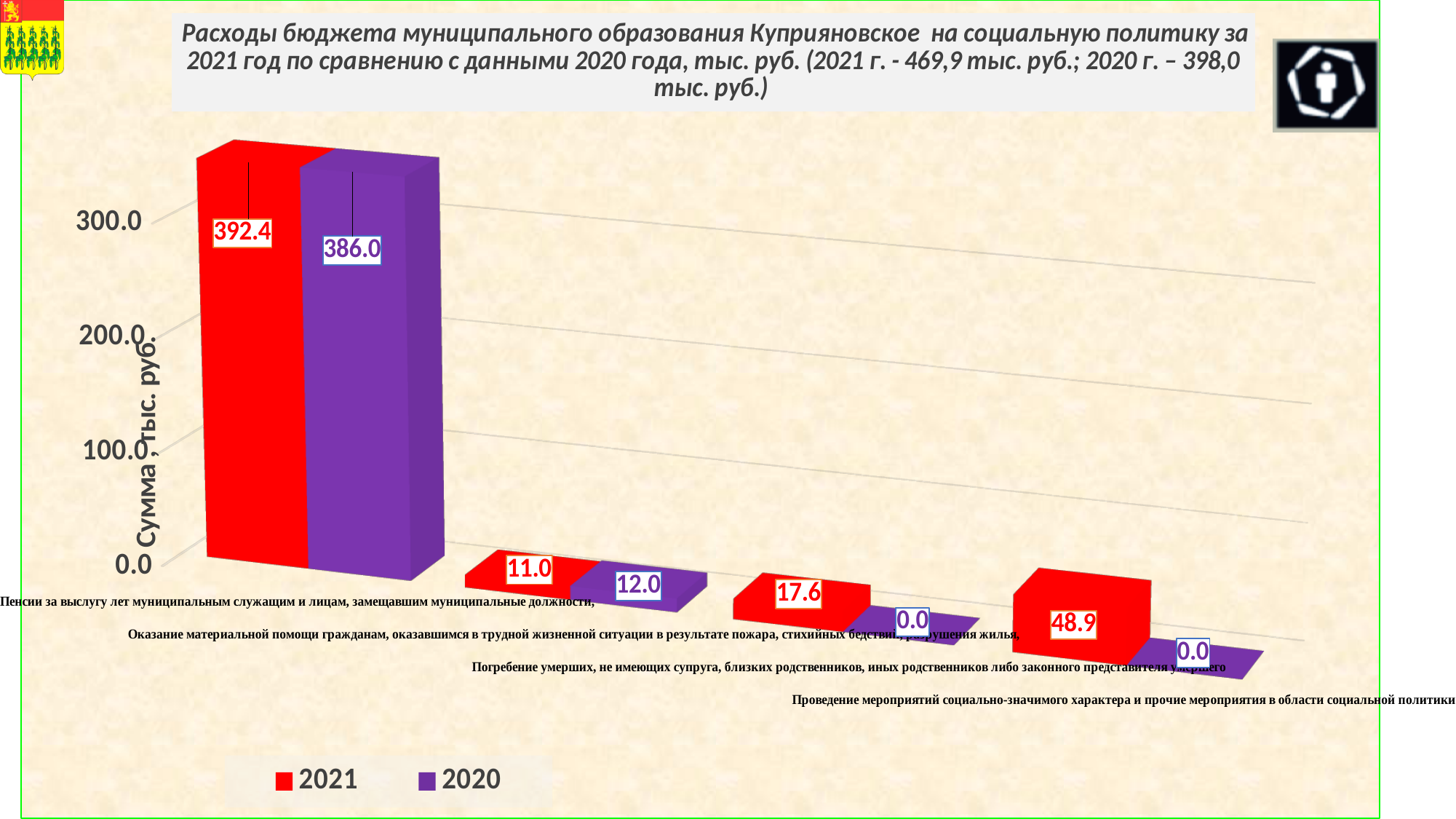
What kind of chart is shown on the slide? Bar chart Which category has the highest 2021 value? Пенсии за выслугу лет муниципальным служащим и лицам, замещавшим муниципальные должности What is the 2021 value for pensions for length of service to municipal employees (Пенсии за выслугу лет)? 392.4 What is the 2021 value for material assistance to citizens in difficult life situations (Оказание материальной помощи)? 11.0 What is the 2021 value for socially significant events and other social policy activities (Проведение мероприятий)? 48.9 Which colour represents the 2020 series in the legend? Purple For material assistance to citizens (Оказание материальной помощи), which year has the larger value, 2021 or 2020? 2020 How many categories are shown on the chart? 4 What is the 2020 value for pensions for length of service to municipal employees (Пенсии за выслугу лет)? 386.0 How many series does the legend list? 2 What is the difference between the 2021 and 2020 values for pensions for length of service (Пенсии за выслугу лет)? 6.4 What is the 2020 value for burial of the deceased without relatives (Погребение умерших)? 0.0